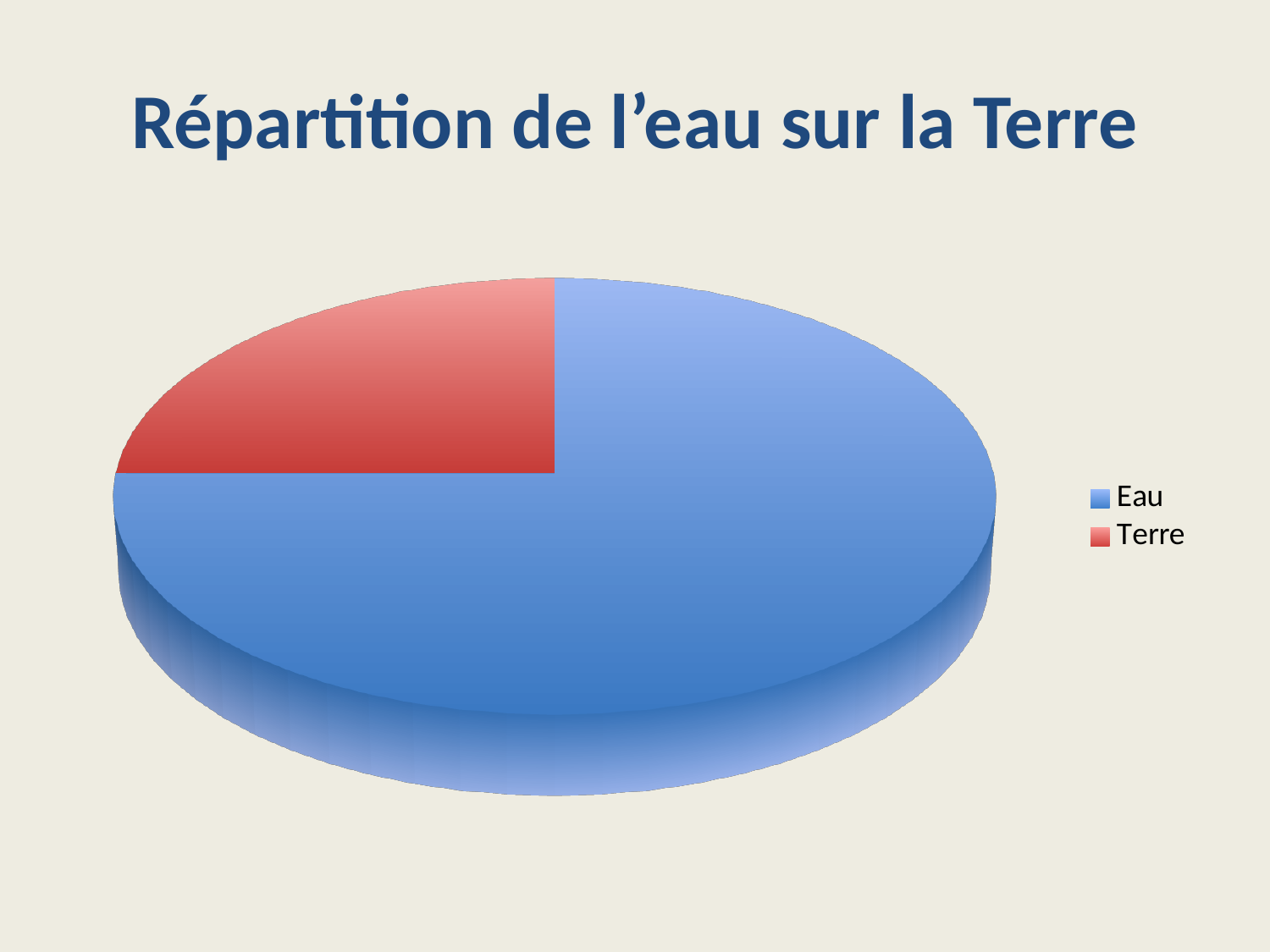
What colour is the Terre slice in the pie chart? red What is the title of the slide containing the pie chart? Répartition de l'eau sur la Terre Which category has the smallest slice of the pie chart? Terre How many entries does the legend of the pie chart list? 2 How many slices does the pie chart have? 2 Which category has the largest slice of the pie chart? Eau What kind of chart is shown on the slide? pie chart Which slice is larger in the pie chart, Eau or Terre? Eau